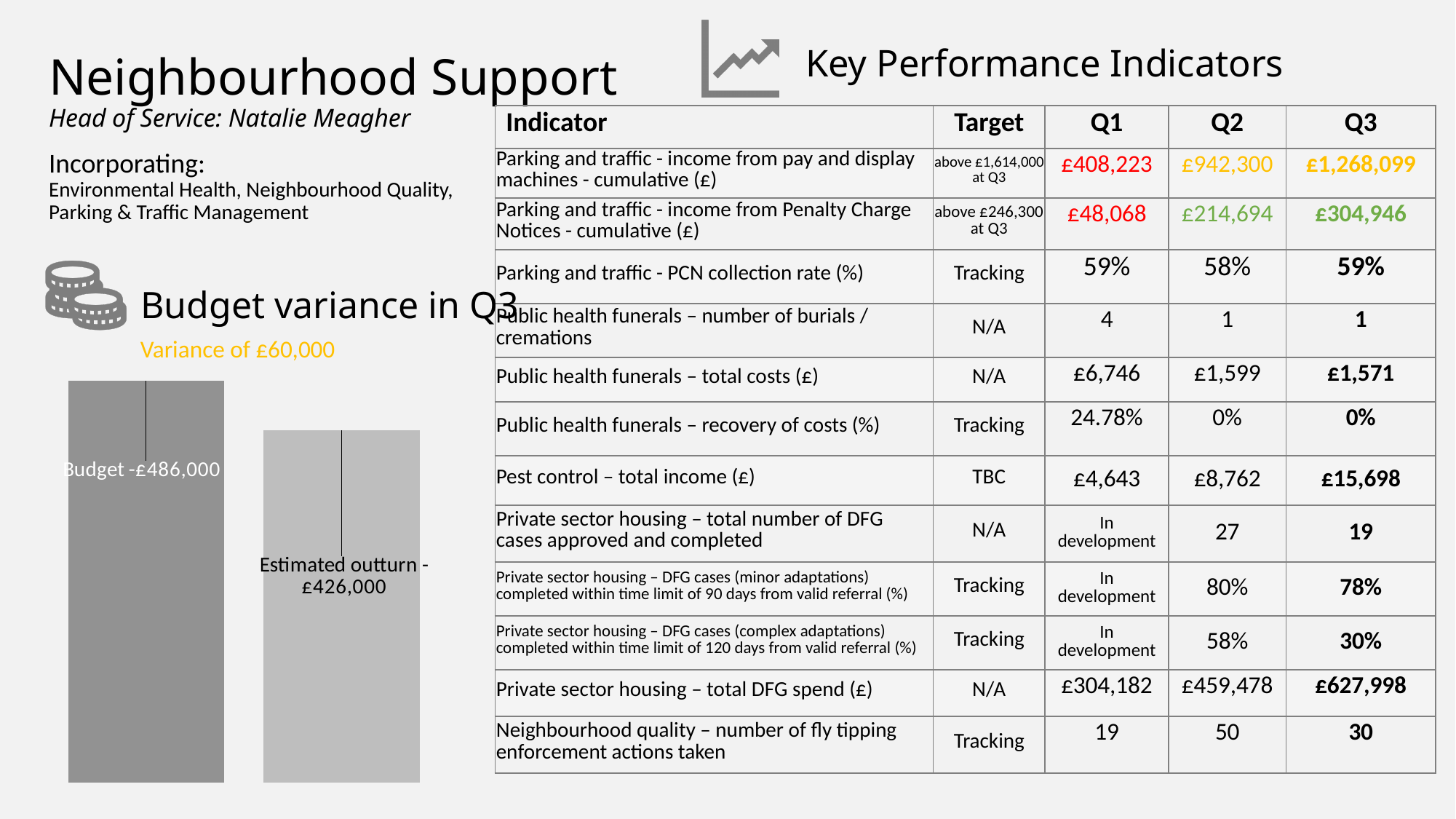
Which bar is taller in the Budget variance in Q3 chart? Budget What is the difference between the Budget and the Estimated outturn in the Budget variance in Q3 chart? £60,000 What type of chart is used to show the budget variance in Q3? Bar chart What variance amount is stated above the Budget variance in Q3 chart? Variance of £60,000 What is the title of the chart on the left of the slide? Budget variance in Q3 What is the value of the Estimated outturn bar in the Budget variance in Q3 chart? £426,000 What is the value of the Budget bar in the Budget variance in Q3 chart? £486,000 Is the Budget or the Estimated outturn larger in the Budget variance in Q3 chart? Budget Which bar has the lowest value in the Budget variance in Q3 chart? Estimated outturn How many bars are shown in the Budget variance in Q3 chart? 2